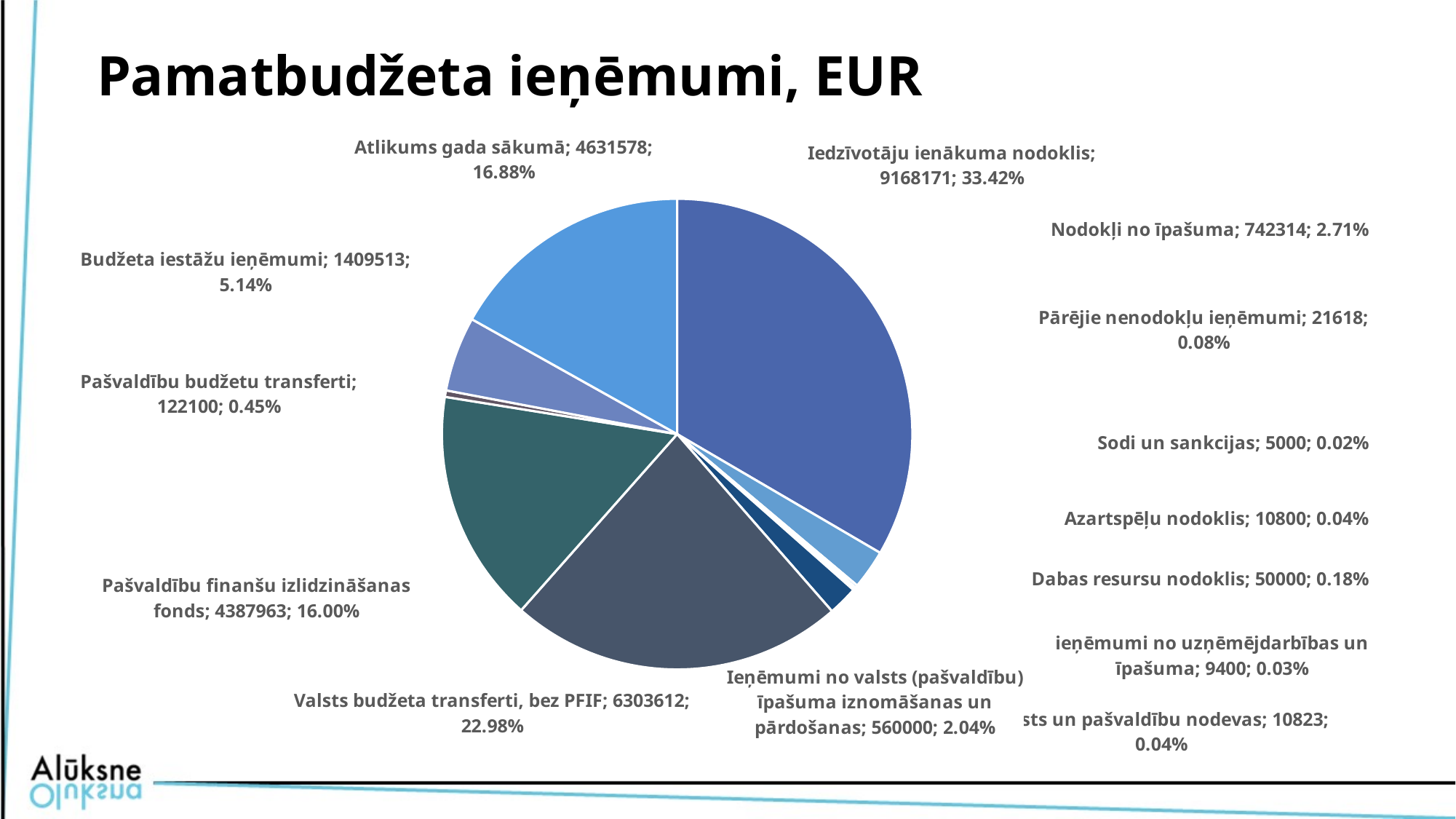
How many slices does the pie chart have? 14 Which is larger, Atlikums gada sākumā or Pašvaldību finanšu izlidzināšanas fonds? Atlikums gada sākumā What share of the pie does Pašvaldību finanšu izlidzināšanas fonds represent? 16.00% What is the value for Atlikums gada sākumā? 4631578 What is the value for Iedzīvotāju ienākuma nodoklis? 9168171 What share of the pie does Budžeta iestāžu ieņēmumi represent? 5.14% Which category has the smallest slice of the pie? Sodi un sankcijas What kind of chart is shown on the slide? pie chart Which category has the largest slice of the pie? Iedzīvotāju ienākuma nodoklis What is the title of the chart? Pamatbudžeta ieņēmumi, EUR What is the value for Valsts budžeta transferti, bez PFIF? 6303612 What is the difference between the values for Iedzīvotāju ienākuma nodoklis and Valsts budžeta transferti, bez PFIF? 2864559